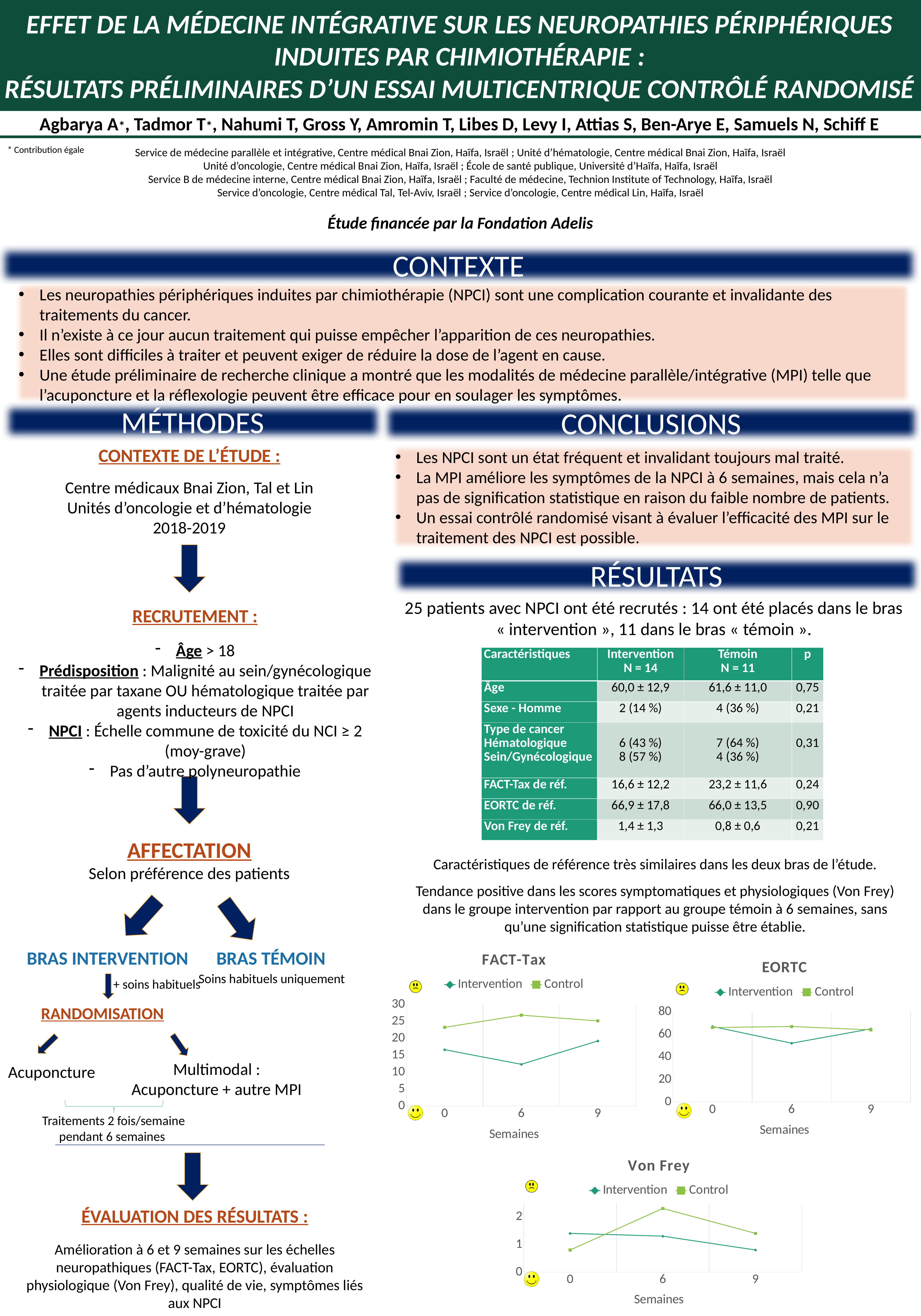
In the EORTC chart, is the Intervention value at week 6 greater or less than 60? less What kind of chart is the FACT-Tax chart? line chart In the FACT-Tax chart, is the Intervention value at week 6 greater or less than 15? less In the EORTC chart, does the Intervention series fall or rise between week 0 and week 6? fall In the FACT-Tax chart, is the Control value at week 6 greater or less than 25? greater In the Von Frey chart, does the Intervention series rise or fall from week 0 to week 9? fall How many series does the legend of the EORTC chart list? 2 In the Von Frey chart, which series has the higher value at week 6, Intervention or Control? Control In the FACT-Tax chart, which series has the higher value at week 6, Intervention or Control? Control What is the x-axis label of the EORTC chart? Semaines How many time points are plotted along the x axis of the Von Frey chart? 3